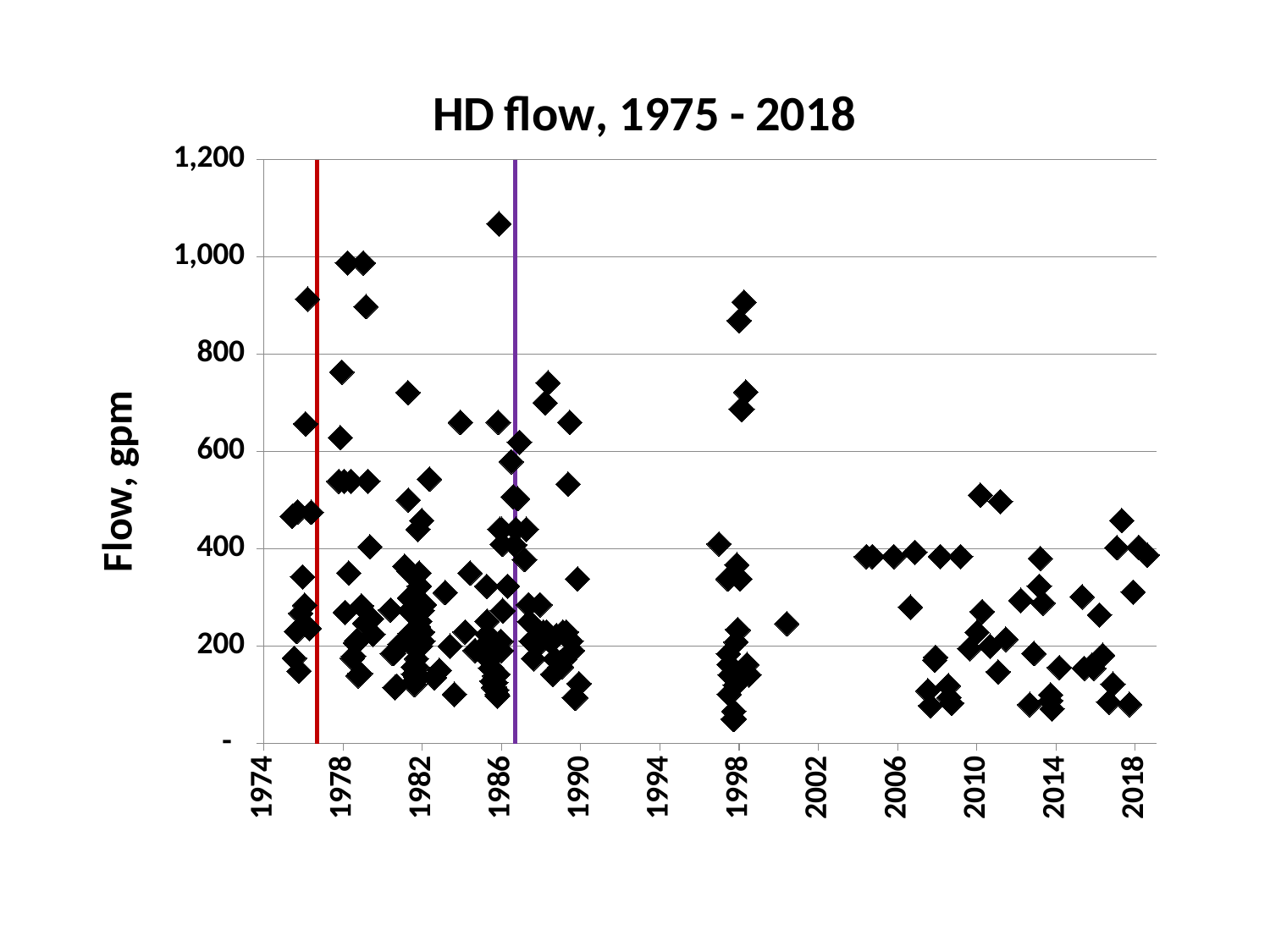
What is the title of the chart? HD flow, 1975 - 2018 What is the highest value shown on the y-axis? 1,200 Is the highest plotted point on the chart greater or less than 1,000 gpm? greater What kind of chart is shown on the slide? scatter plot Is the single point plotted around 2000 greater or less than 400 gpm? less Around which x-axis year does the highest plotted point appear? 1986 How many vertical coloured lines are drawn on the chart? 2 What is the last year labelled on the x-axis? 2018 Are there any data points plotted between 1991 and 1996? no Is the highest point plotted around 2010 greater or less than 600 gpm? less What is the label on the y-axis of the chart? Flow, gpm